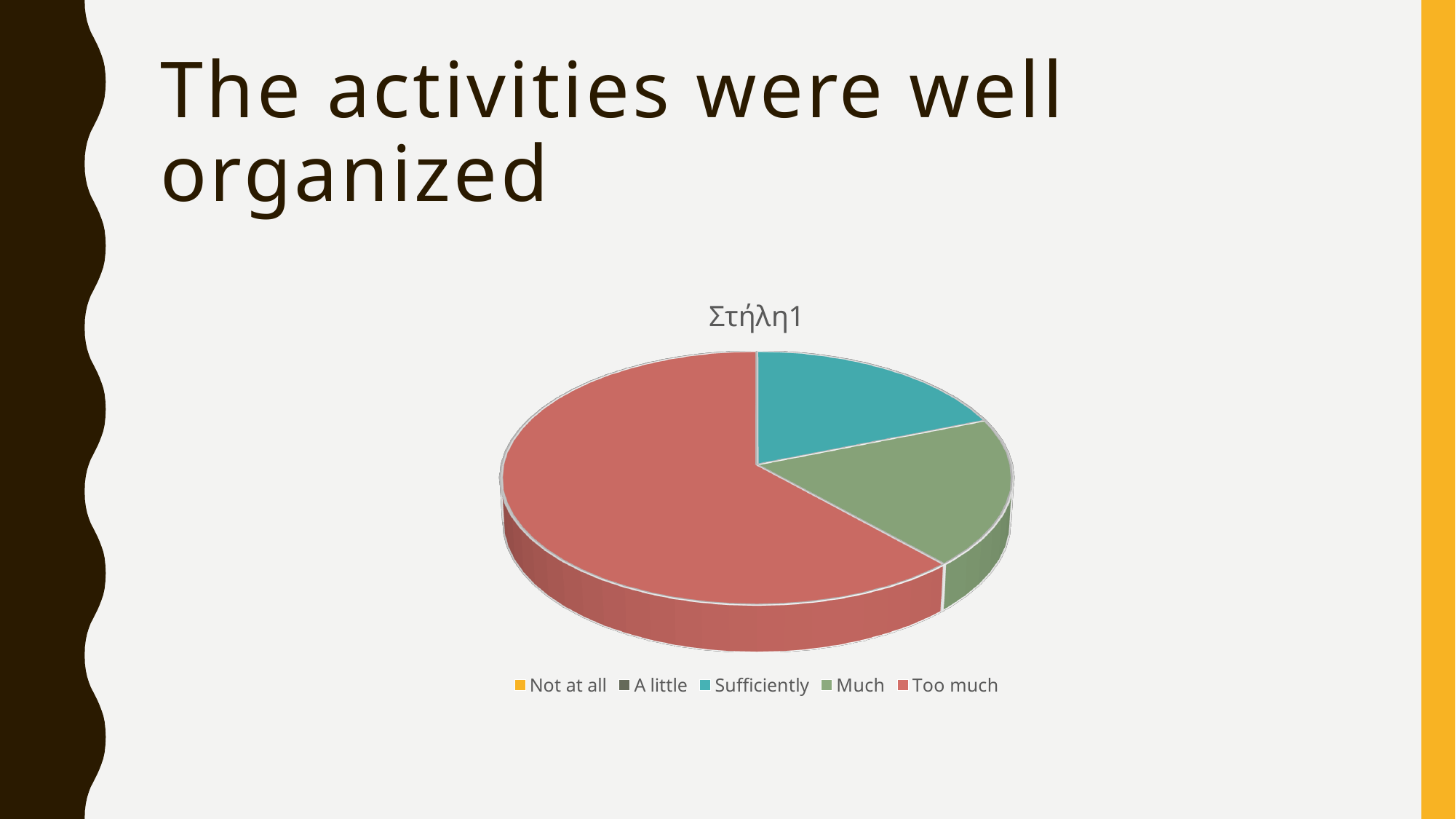
How many slices are visible in the pie? 3 What kind of chart is shown on the slide? pie chart Which is larger, the slice for Too much or the slice for Sufficiently? Too much Which category has the largest slice of the pie? Too much What is the title shown above the pie chart? Στήλη1 How many entries does the legend list? 5 Which is larger, the slice for Too much or the slice for Much? Too much Does the slice for Too much take up more or less than half of the pie? more What colour is the slice for Too much? red